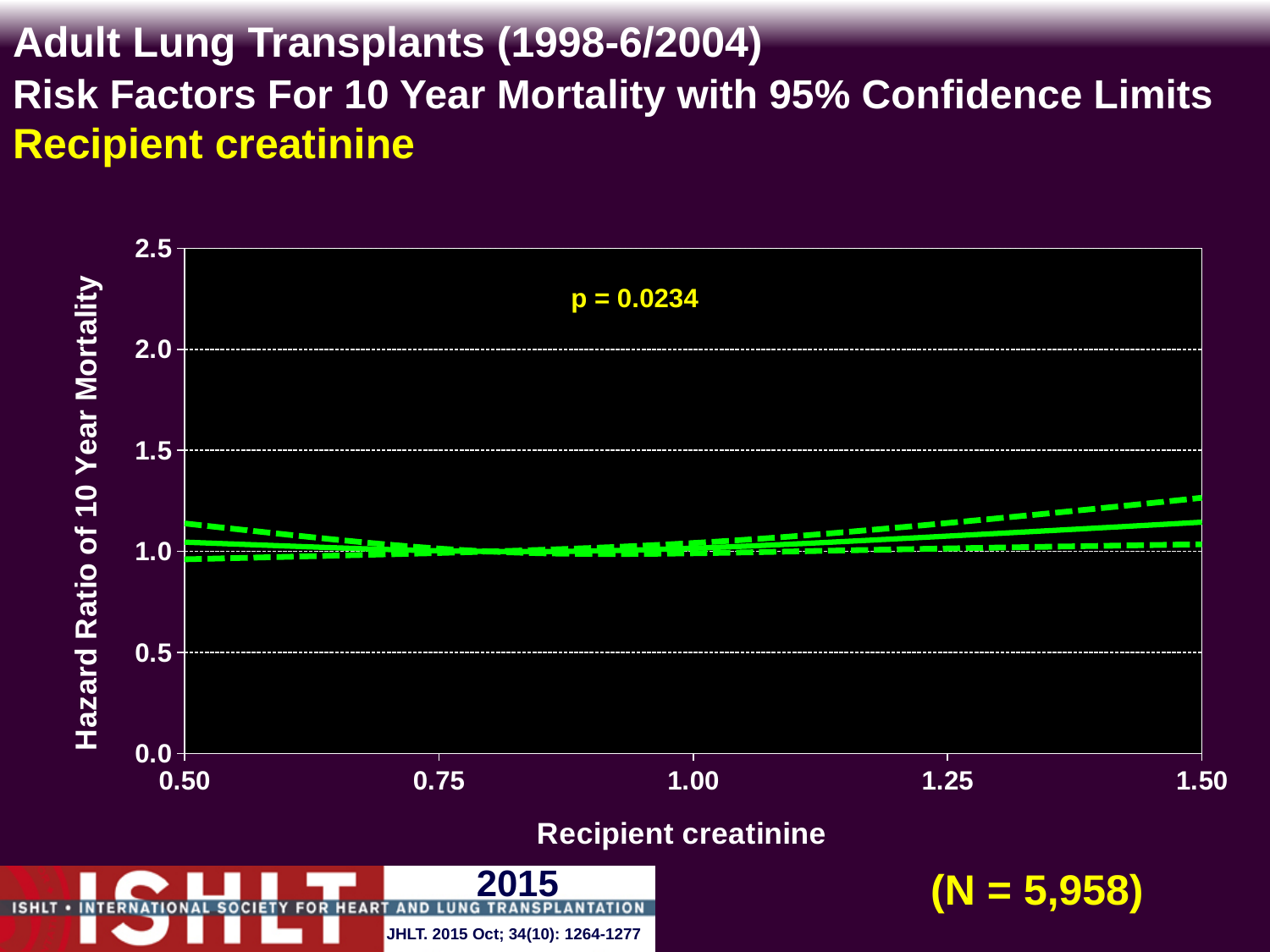
Is the upper 95% confidence limit at a recipient creatinine of 1.50 greater or less than 1.5? less Is the hazard ratio higher at a recipient creatinine of 1.50 or at 1.00? 1.50 What is the sample size (N) shown on the slide? 5,958 How many lines are plotted on the chart (the estimate plus its confidence limits)? 3 Is the hazard ratio (solid line) at a recipient creatinine of 1.50 greater or less than 1.5? less What is the label of the y axis? Hazard Ratio of 10 Year Mortality Is the hazard ratio (solid line) at a recipient creatinine of 1.50 greater or less than 1.0? greater What kind of chart is shown on the slide? line chart How many tick labels are shown on the x axis? 5 What is the p-value printed on the chart? p = 0.0234 Does the hazard ratio rise or fall as recipient creatinine increases from 1.00 to 1.50? rise